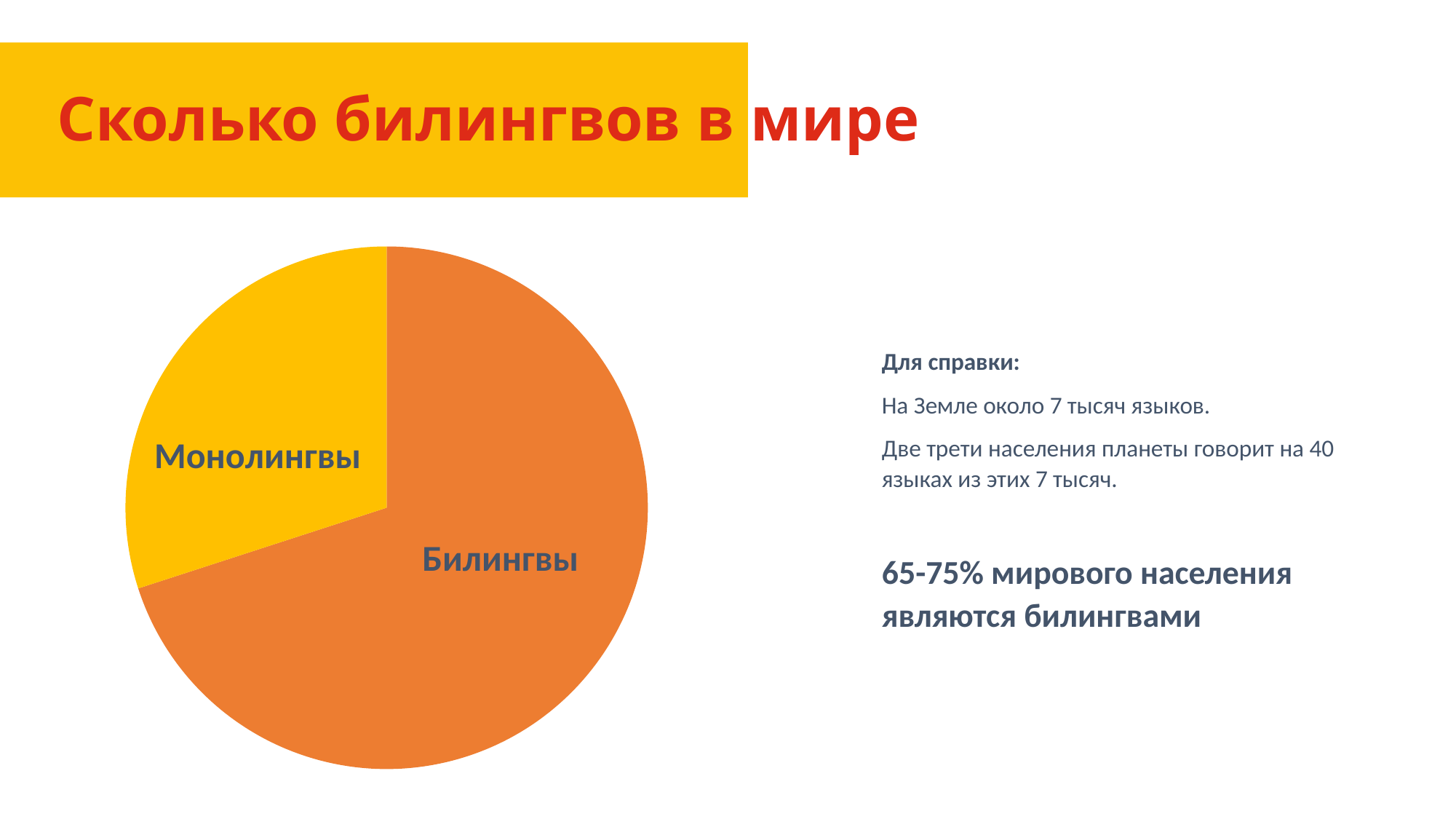
What colour is the Монолингвы slice of the pie chart? Yellow Which slice of the pie chart is the smallest? Монолингвы How many slices does the pie chart have? 2 What is the title of the slide containing the pie chart? Сколько билингвов в мире Which slice of the pie chart is the largest? Билингвы What kind of chart is shown on the slide? Pie chart Which slice is larger, Монолингвы or Билингвы? Билингвы Does the Билингвы slice take up more or less than half of the pie? More